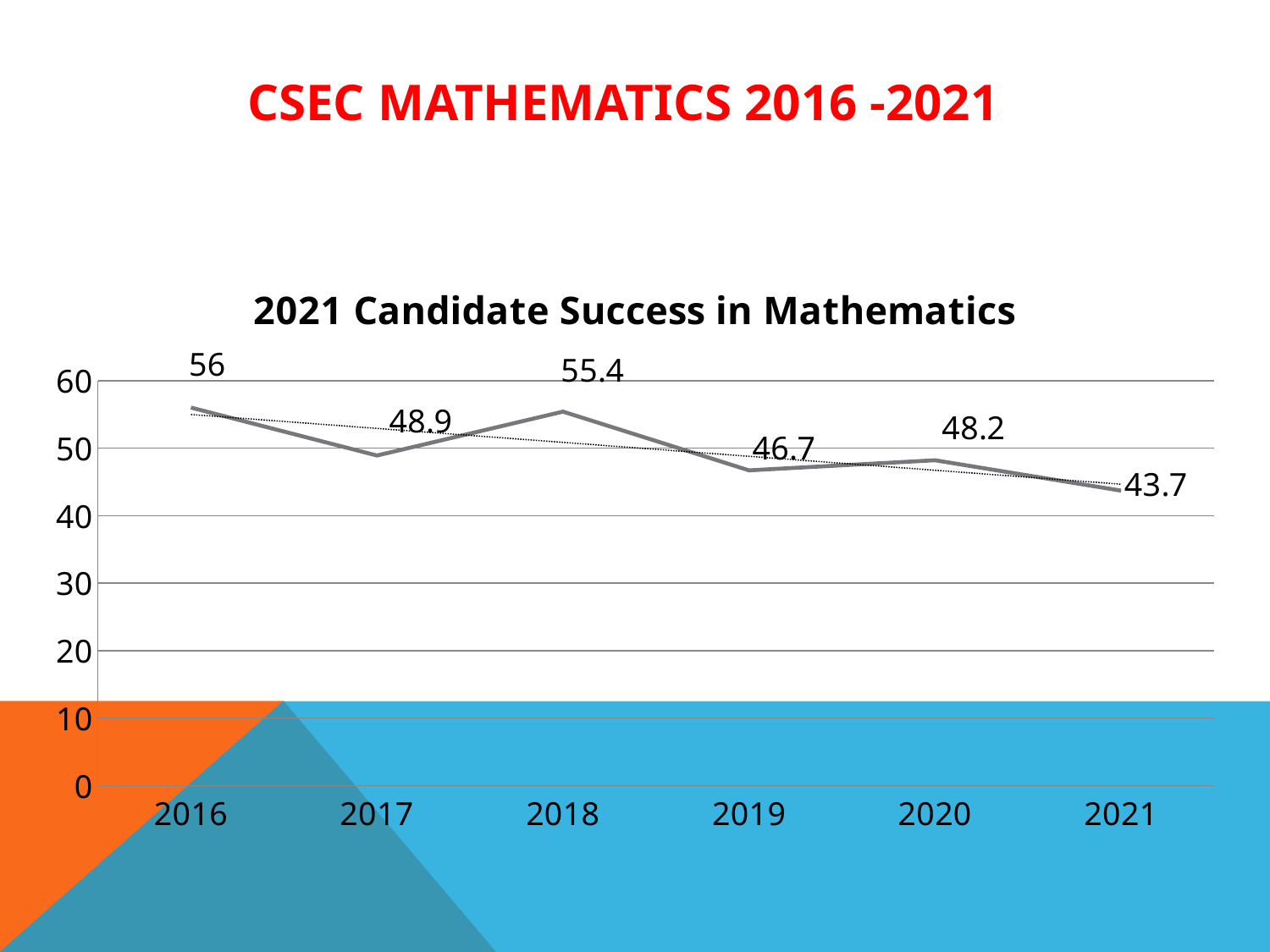
What is the title of the chart? 2021 Candidate Success in Mathematics What is the value for 2016? 56 What kind of chart is shown? line chart Is the value for 2019 greater or less than 50? less What is the value for 2018? 55.4 How many years are plotted on the chart? 6 What is the value for 2019? 46.7 Which is larger, the value for 2017 or the value for 2020? 2017 What is the difference between the values for 2016 and 2021? 12.3 Which year has the lowest value? 2021 What is the value for 2021? 43.7 Which year has the highest value? 2016